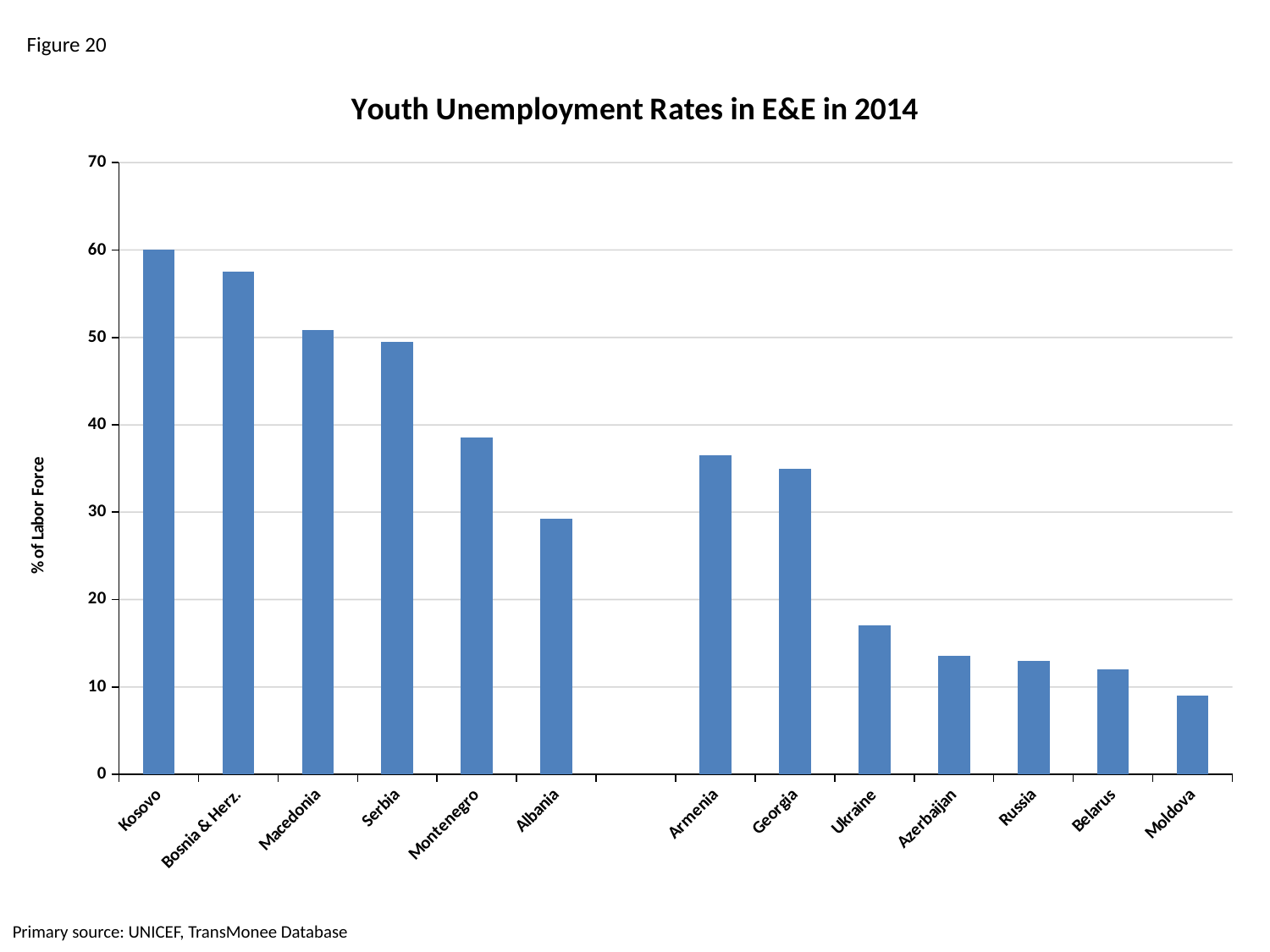
Do the values generally rise or fall moving from left to right along the x axis? fall Which country has the highest youth unemployment rate? Kosovo Is the value for Ukraine greater or less than 20? less What kind of chart is shown on the slide? bar chart Is the value for Bosnia & Herz. greater or less than 50? greater Is the value for Albania greater or less than 30? less What is the label of the vertical axis? % of Labor Force How many countries are shown on the chart? 13 What is the title of the chart? Youth Unemployment Rates in E&E in 2014 Which has a higher youth unemployment rate, Montenegro or Albania? Montenegro Which country has the lowest youth unemployment rate? Moldova